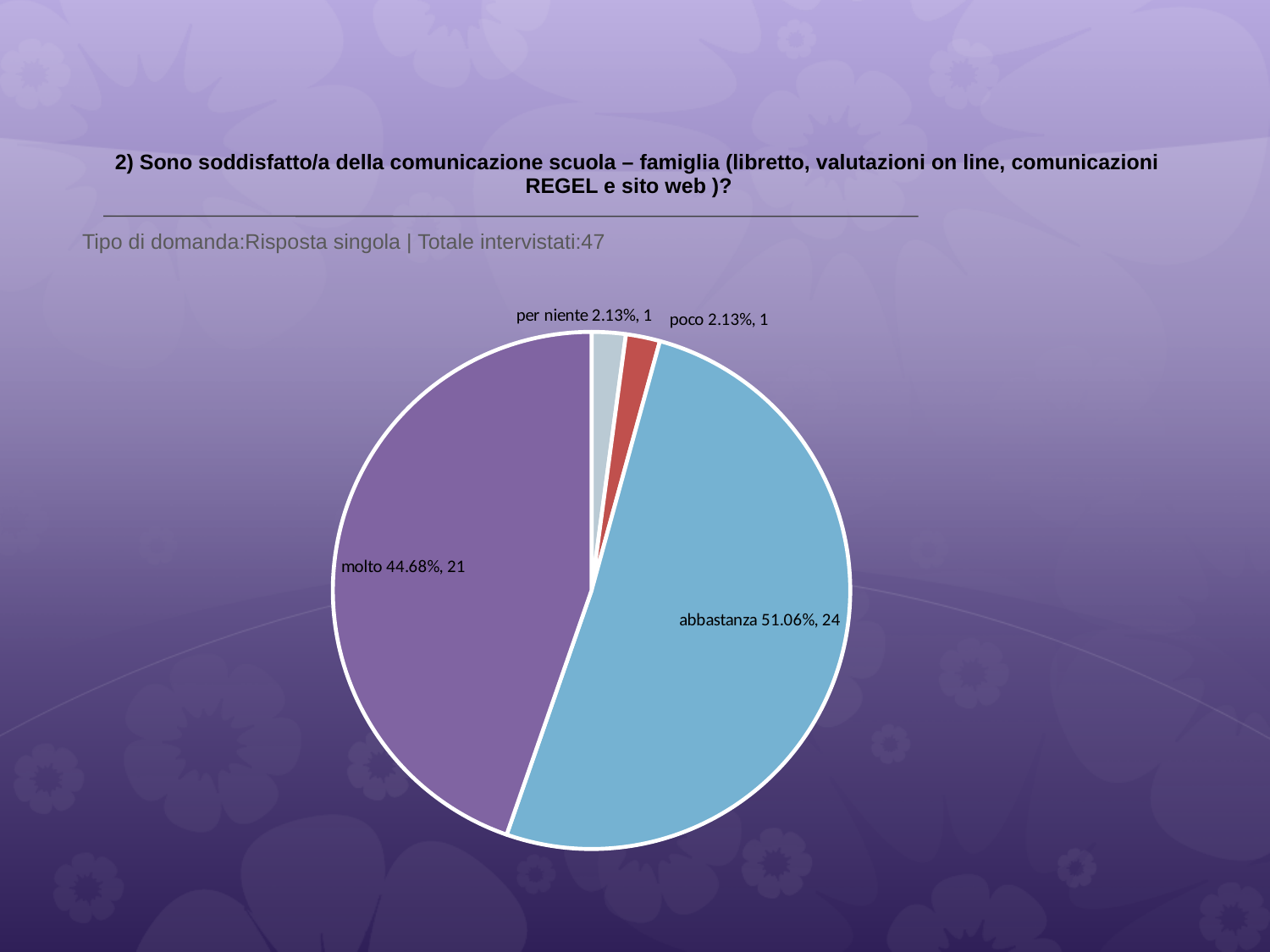
What percentage of respondents answered "per niente"? 2.13% What percentage of respondents answered "abbastanza"? 51.06% Which response has the largest share of the pie? abbastanza What is the difference in number of respondents between "abbastanza" and "molto"? 3 What kind of chart is shown on the slide? pie chart How many respondents answered "poco"? 1 What colour is the "abbastanza" slice of the pie chart? light blue How many slices does the pie chart have? 4 What is the share of the pie for the "molto" slice? 44.68% How many respondents answered "molto"? 21 What is the total number of respondents (Totale intervistati) shown on the slide? 47 Which has more respondents, "molto" or "abbastanza"? abbastanza